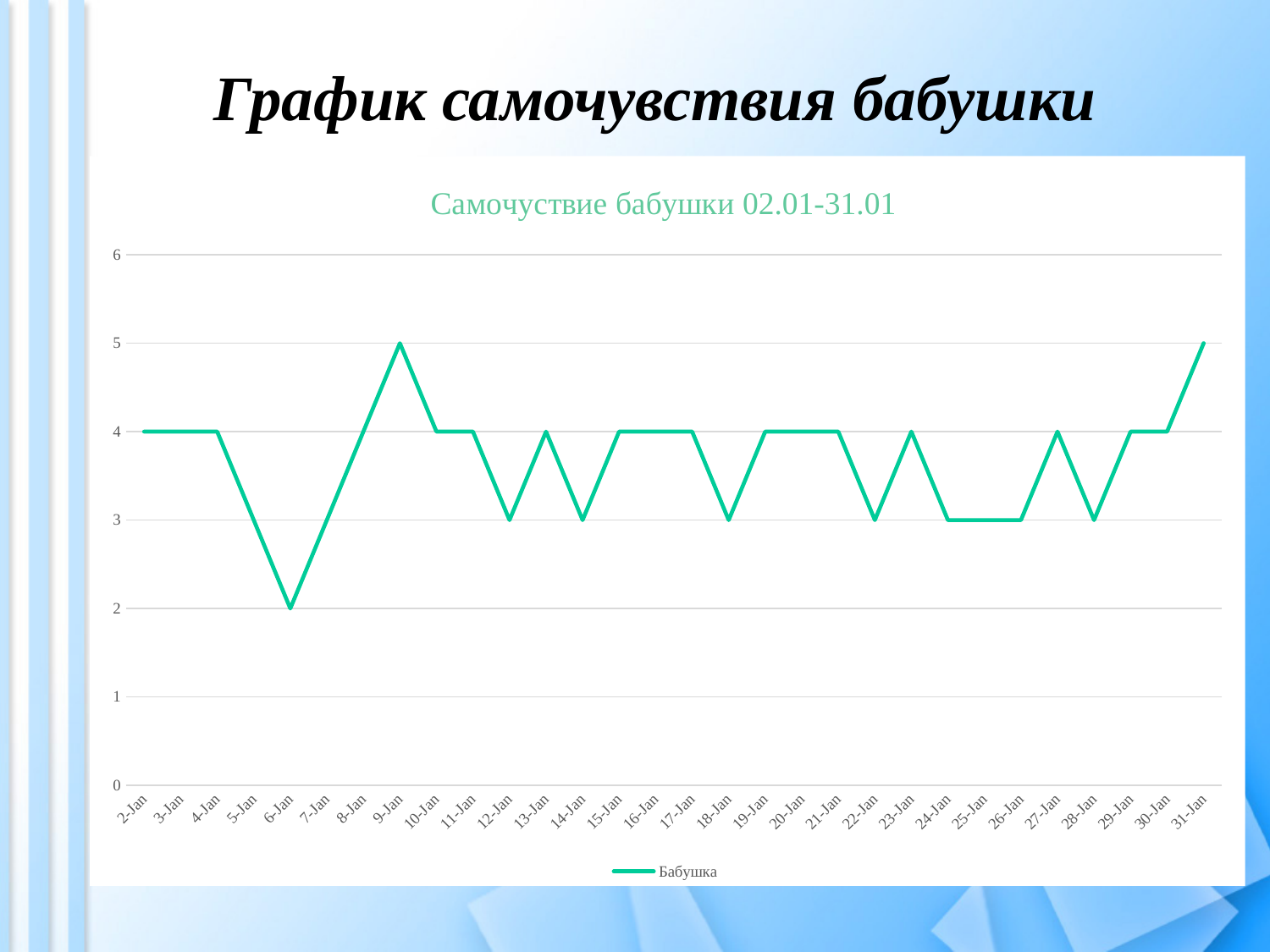
On which date is the value lowest? 6-Jan What is the highest value reached on the chart? 5 What is the title of the chart? Самочуствие бабушки 02.01-31.01 What is the value for 6-Jan? 2 How many dates are plotted along the x axis? 30 Which is larger, the value for 31-Jan or the value for 28-Jan? 31-Jan How many series does the legend list? 1 What is the difference between the values for 9-Jan and 6-Jan? 3 What kind of chart is shown on the slide? line chart What is the name of the series in the legend? Бабушка What is the value for 2-Jan? 4 What is the value for 9-Jan? 5